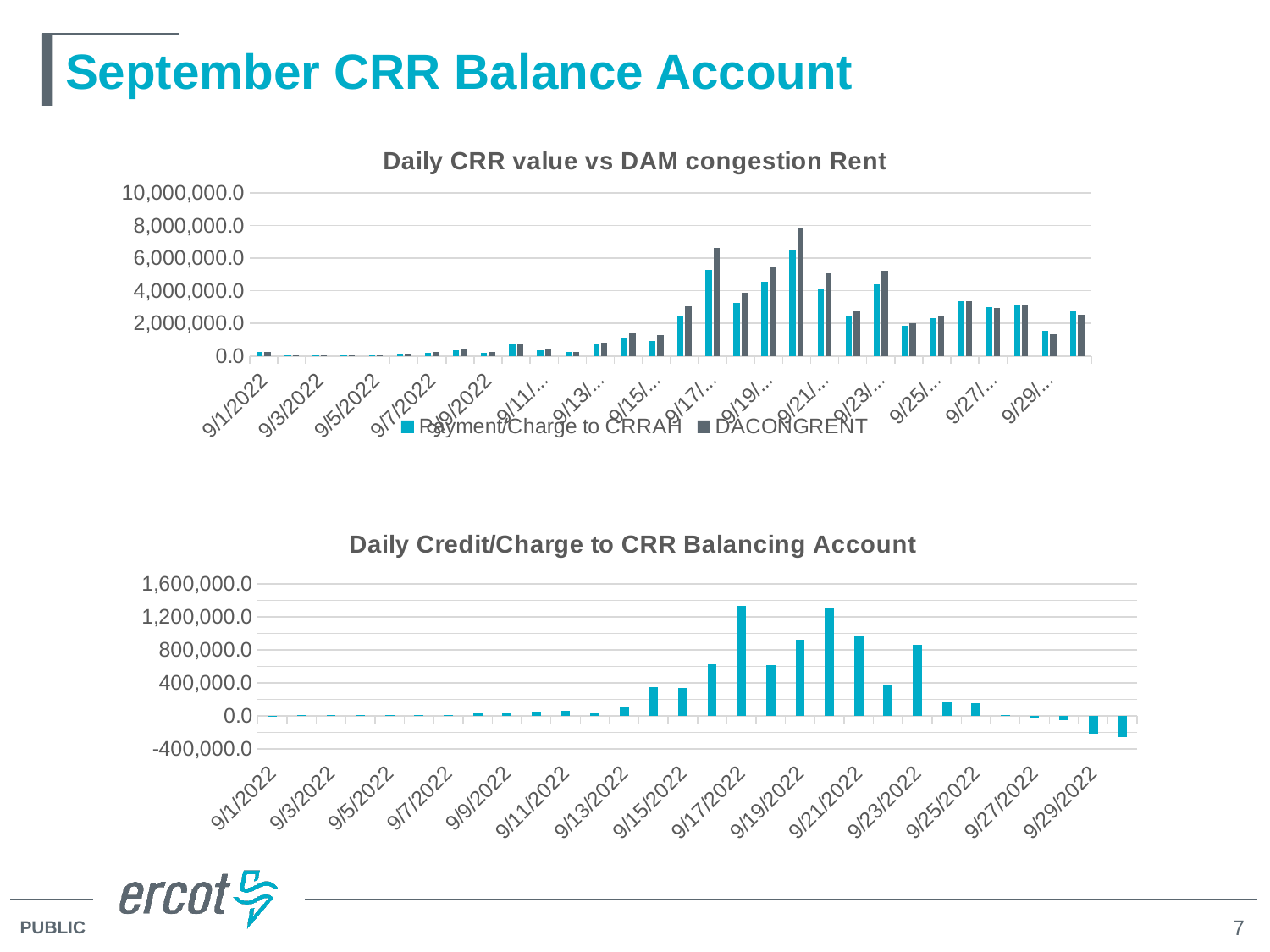
In the top chart 'Daily CRR value vs DAM congestion Rent', is the DACONGRENT value for 9/1/2022 greater or less than 2,000,000.0? less In the bottom chart 'Daily Credit/Charge to CRR Balancing Account', is the value for 9/15/2022 greater or less than 400,000.0? less In the top chart 'Daily CRR value vs DAM congestion Rent', is the DACONGRENT value for 9/17 greater or less than 6,000,000.0? greater In the bottom chart 'Daily Credit/Charge to CRR Balancing Account', do the values generally rise or fall from 9/23/2022 to 9/29/2022? fall What are the two series named in the legend of the top chart 'Daily CRR value vs DAM congestion Rent'? Payment/Charge to CRRAH and DACONGRENT What kind of chart is the top chart titled 'Daily CRR value vs DAM congestion Rent'? bar chart What is the title of the bottom chart on the slide? Daily Credit/Charge to CRR Balancing Account In the bottom chart 'Daily Credit/Charge to CRR Balancing Account', which date has the larger value: 9/19/2022 or 9/25/2022? 9/19/2022 In the top chart 'Daily CRR value vs DAM congestion Rent', which series has the larger value on 9/17: Payment/Charge to CRRAH or DACONGRENT? DACONGRENT How many series does the legend of the top chart 'Daily CRR value vs DAM congestion Rent' list? 2